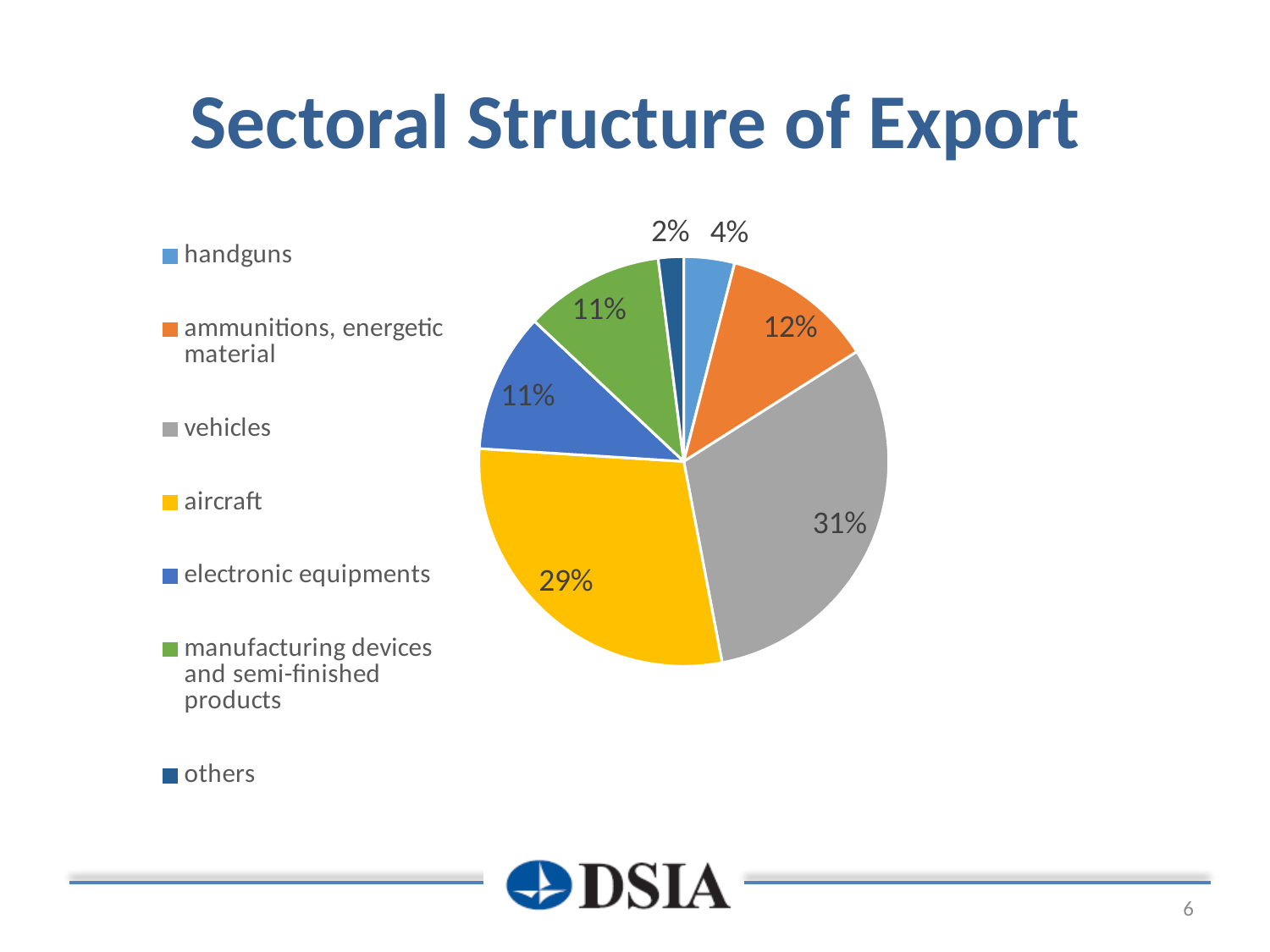
What share of export does the ammunitions, energetic material sector account for? 12% What share of export does the handguns sector account for? 4% Which sector has the largest share of export? vehicles What share of export does the others category account for? 2% What is the difference in share between vehicles and aircraft? 2% What is the title of the chart? Sectoral Structure of Export Which has a larger share of export, ammunitions, energetic material or handguns? ammunitions, energetic material What share of export does the aircraft sector account for? 29% What type of chart is shown on the slide? pie chart How many categories does the pie chart show? 7 What share of export does the vehicles sector account for? 31% Which category has the smallest share of export? others